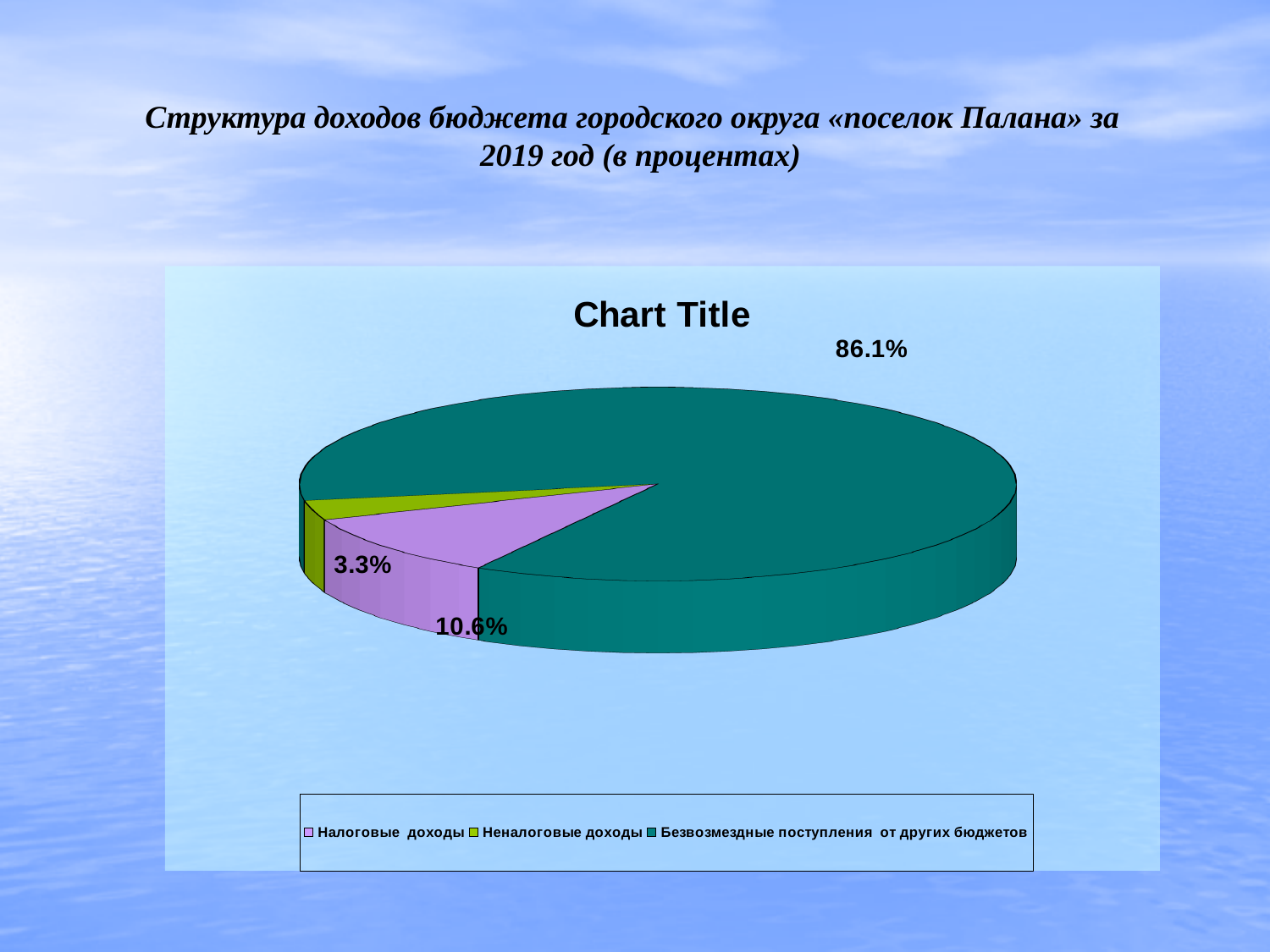
How many entries does the legend list? 3 What kind of chart is shown on the slide? pie chart What is the difference between the values for Налоговые доходы and Неналоговые доходы? 7.3% What is the value for Неналоговые доходы? 3.3% Which category has the smallest share of the pie? Неналоговые доходы What is the difference between the values for Безвозмездные поступления от других бюджетов and Налоговые доходы? 75.5% Which category has the largest share of the pie? Безвозмездные поступления от других бюджетов What is the value for Налоговые доходы? 10.6% What is the value for Безвозмездные поступления от других бюджетов? 86.1% How many categories does the pie chart have? 3 What colour is the slice for Неналоговые доходы? green Which is larger, Налоговые доходы or Неналоговые доходы? Налоговые доходы